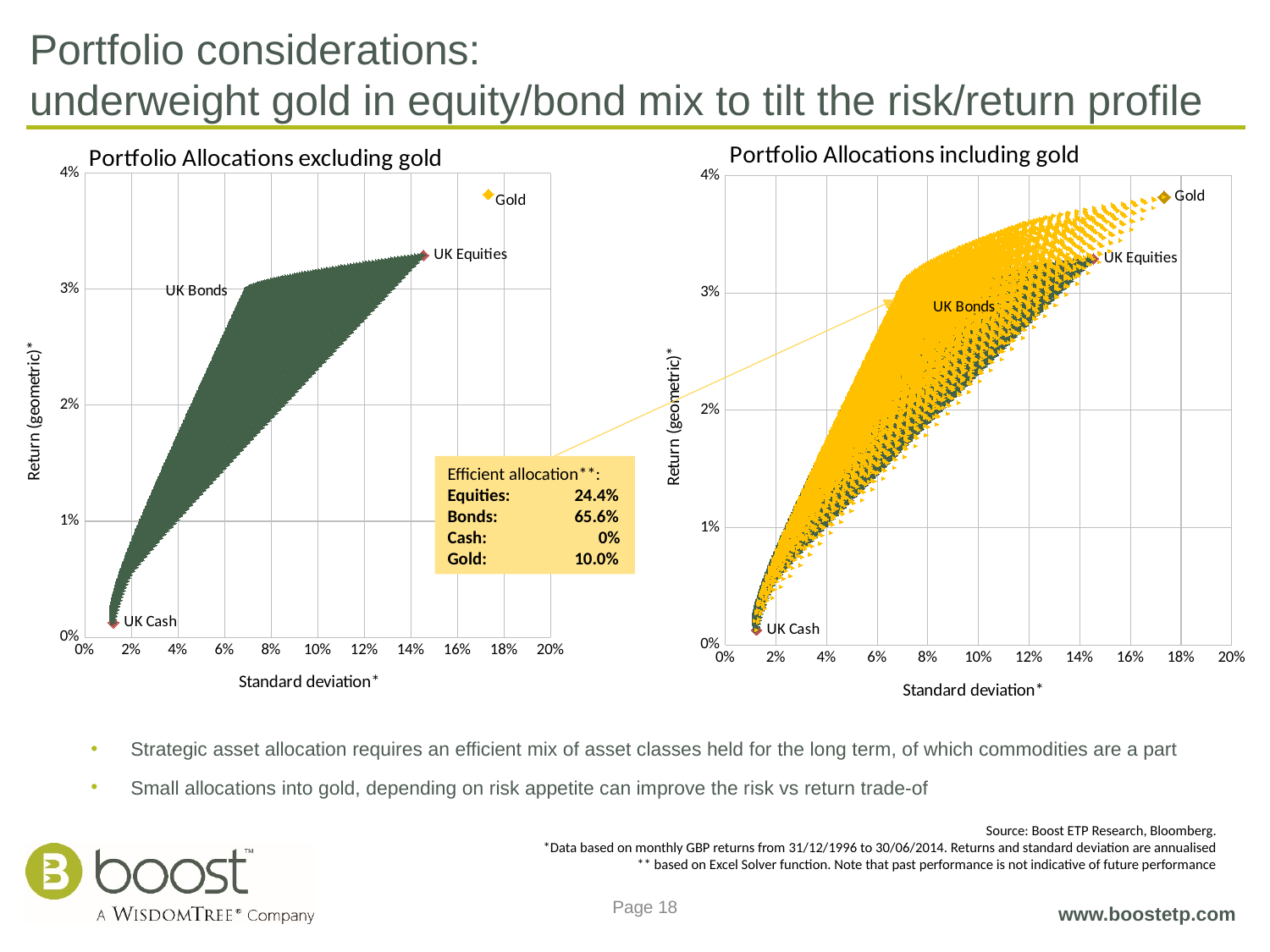
In the 'Portfolio Allocations excluding gold' chart, which labelled asset has the lowest return? UK Cash In the 'Portfolio Allocations including gold' chart, is the standard deviation for UK Bonds greater or less than 10%? less What is the label of the x axis on the 'Portfolio Allocations excluding gold' chart? Standard deviation* In the 'Portfolio Allocations including gold' chart, which labelled asset has the highest standard deviation? Gold What kind of chart is the 'Portfolio Allocations excluding gold' chart? Scatter chart In the 'Portfolio Allocations including gold' chart, which labelled asset has the highest return? Gold How many labelled asset classes are shown in the 'Portfolio Allocations including gold' chart? 4 In the 'Portfolio Allocations excluding gold' chart, is the return for Gold greater or less than 3%? greater In the 'Portfolio Allocations excluding gold' chart, which has the higher return, UK Equities or UK Bonds? UK Equities In the 'Portfolio Allocations including gold' chart, is the standard deviation for Gold greater or less than 16%? greater According to the 'Efficient allocation' box on the slide, what is the allocation to Bonds? 65.6%